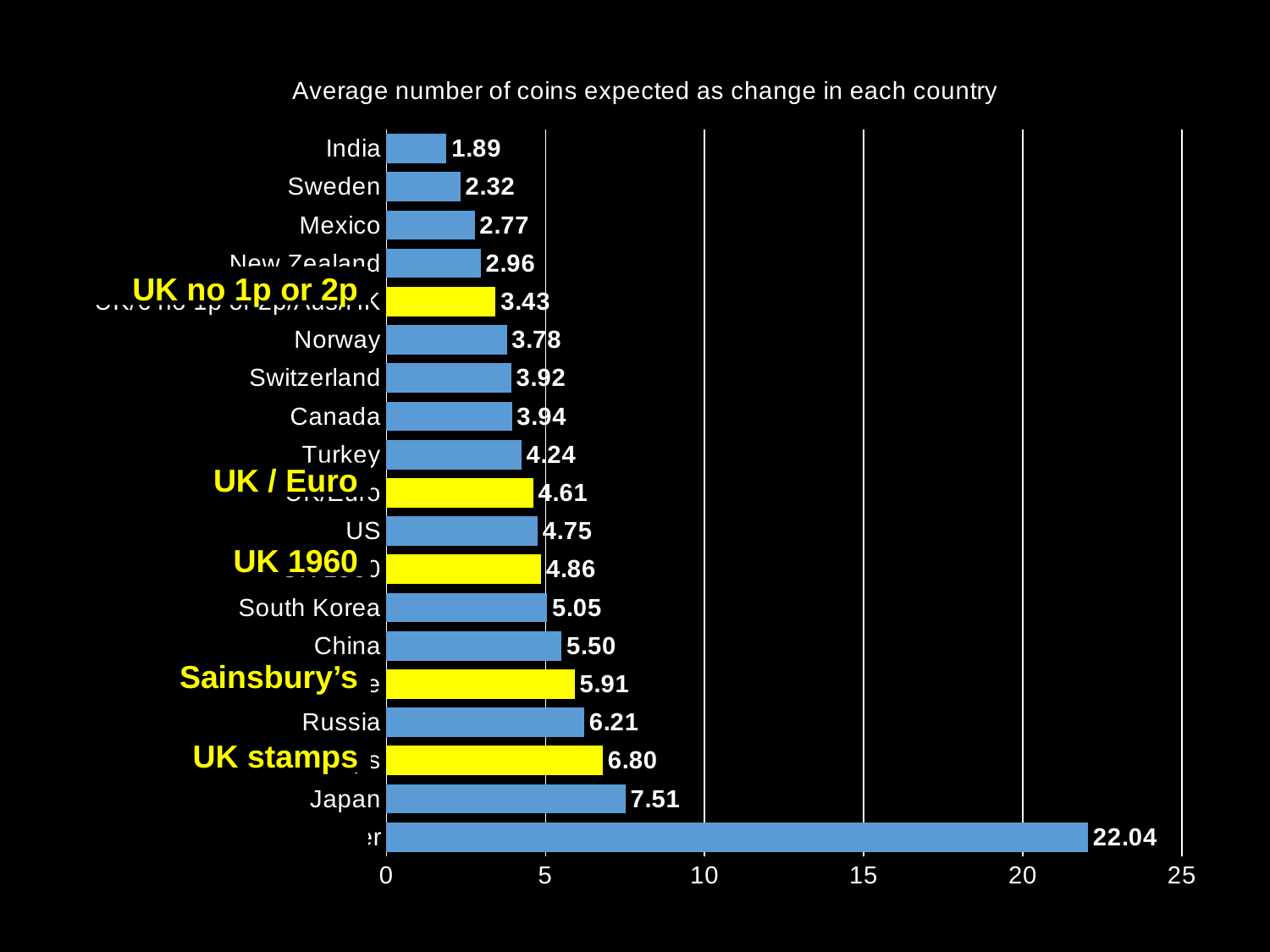
What is the value for the UK / Euro bar? 4.61 What is the average number of coins expected as change in India? 1.89 Which has a higher value, South Korea or US? South Korea What value is shown for Sainsbury's? 5.91 What is the difference between the values for UK stamps and UK 1960? 1.94 Which has a higher value, Norway or Turkey? Turkey What type of chart is shown on the slide? Bar chart What is the difference between the values for Russia and China? 0.71 Which country has the lowest average number of coins expected as change? India What is the title of the chart? Average number of coins expected as change in each country What value is shown for Japan? 7.51 How many bars are plotted in the chart? 19